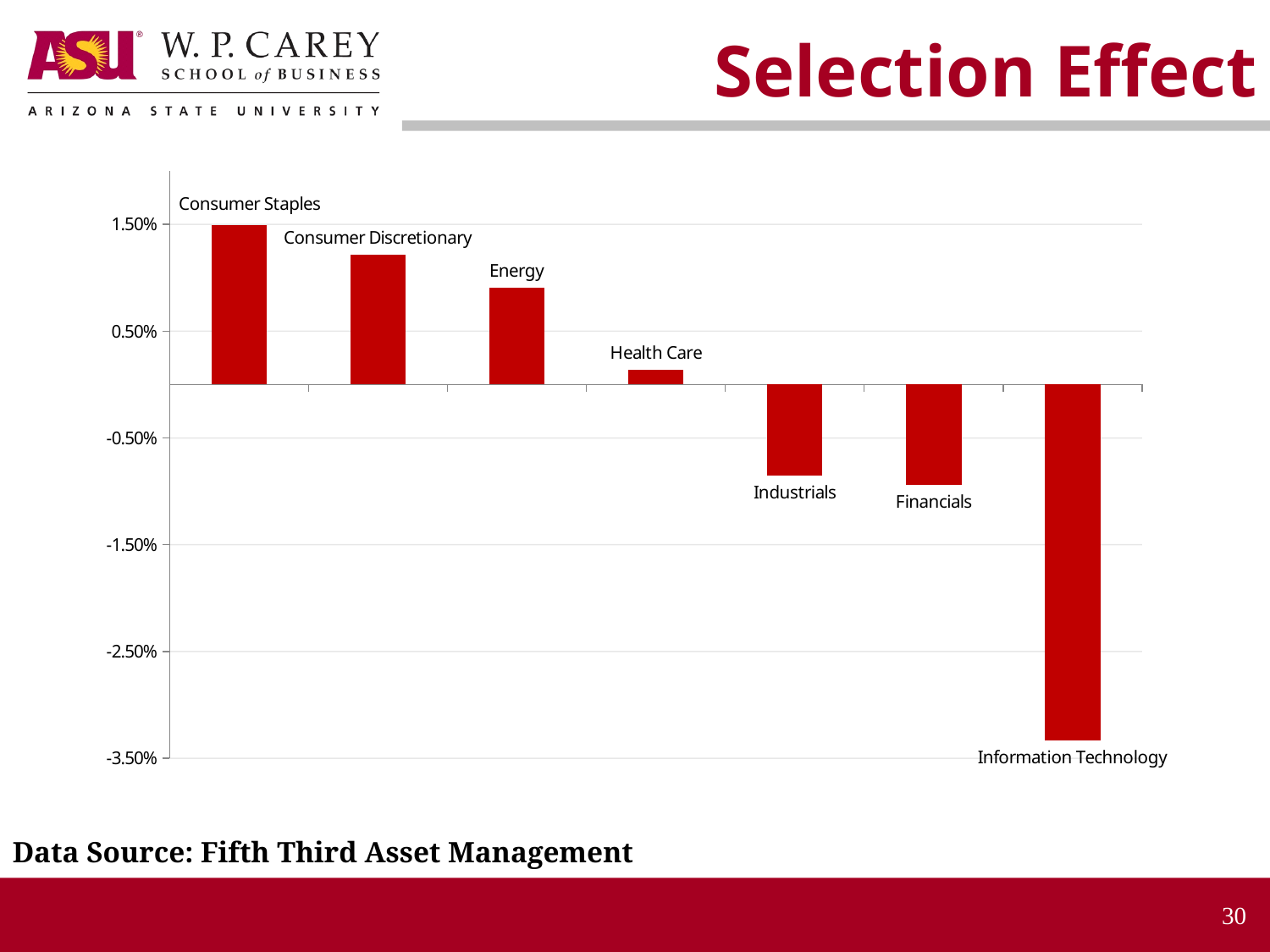
Is the value for Health Care greater or less than 0.50%? less What is the title of the slide containing the chart? Selection Effect How many sectors (bars) are plotted in the chart? 7 Which is larger, the value for Consumer Discretionary or the value for Energy? Consumer Discretionary Is the value for Information Technology greater or less than -2.50%? less Is the value for Financials greater or less than -1.50%? greater Which sector has the highest selection effect? Consumer Staples What kind of chart is shown on the slide? Bar chart Do the values rise or fall moving from left to right across the chart? Fall Which sector has the lowest selection effect? Information Technology